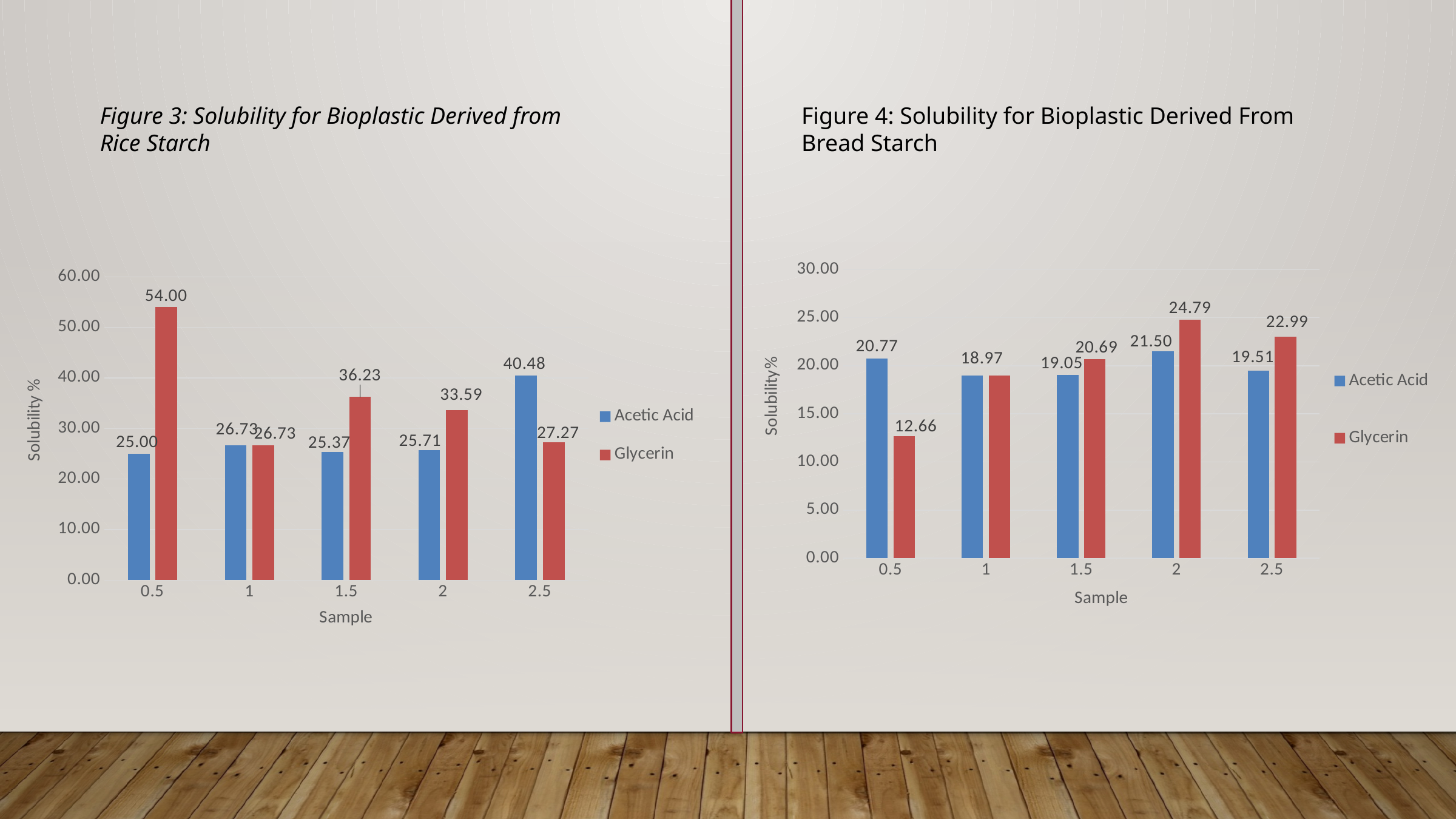
In Figure 4 (Bread Starch), for sample 2.5, which is larger: Acetic Acid or Glycerin? Glycerin In Figure 3 (Rice Starch), which sample has the highest Glycerin solubility? 0.5 In Figure 3 (Rice Starch), what is the Acetic Acid solubility for sample 2.5? 40.48 How many sample categories are shown on the x axis of Figure 4 (Bread Starch)? 5 In Figure 4 (Bread Starch), which sample has the lowest Glycerin solubility? 0.5 In Figure 3 (Rice Starch), for sample 2.5, which is larger: Acetic Acid or Glycerin? Acetic Acid In Figure 3 (Rice Starch), what is the difference between the Glycerin and Acetic Acid values for sample 0.5? 29.00 In Figure 3 (Rice Starch), what is the Glycerin solubility for sample 0.5? 54.00 How many series does the legend of Figure 3 (Rice Starch) list? 2 In Figure 4 (Bread Starch), which sample has the highest Acetic Acid solubility? 2 In Figure 4 (Bread Starch), what is the Glycerin solubility for sample 2? 24.79 In Figure 4 (Bread Starch), what is the difference between the Acetic Acid and Glycerin values for sample 0.5? 8.11